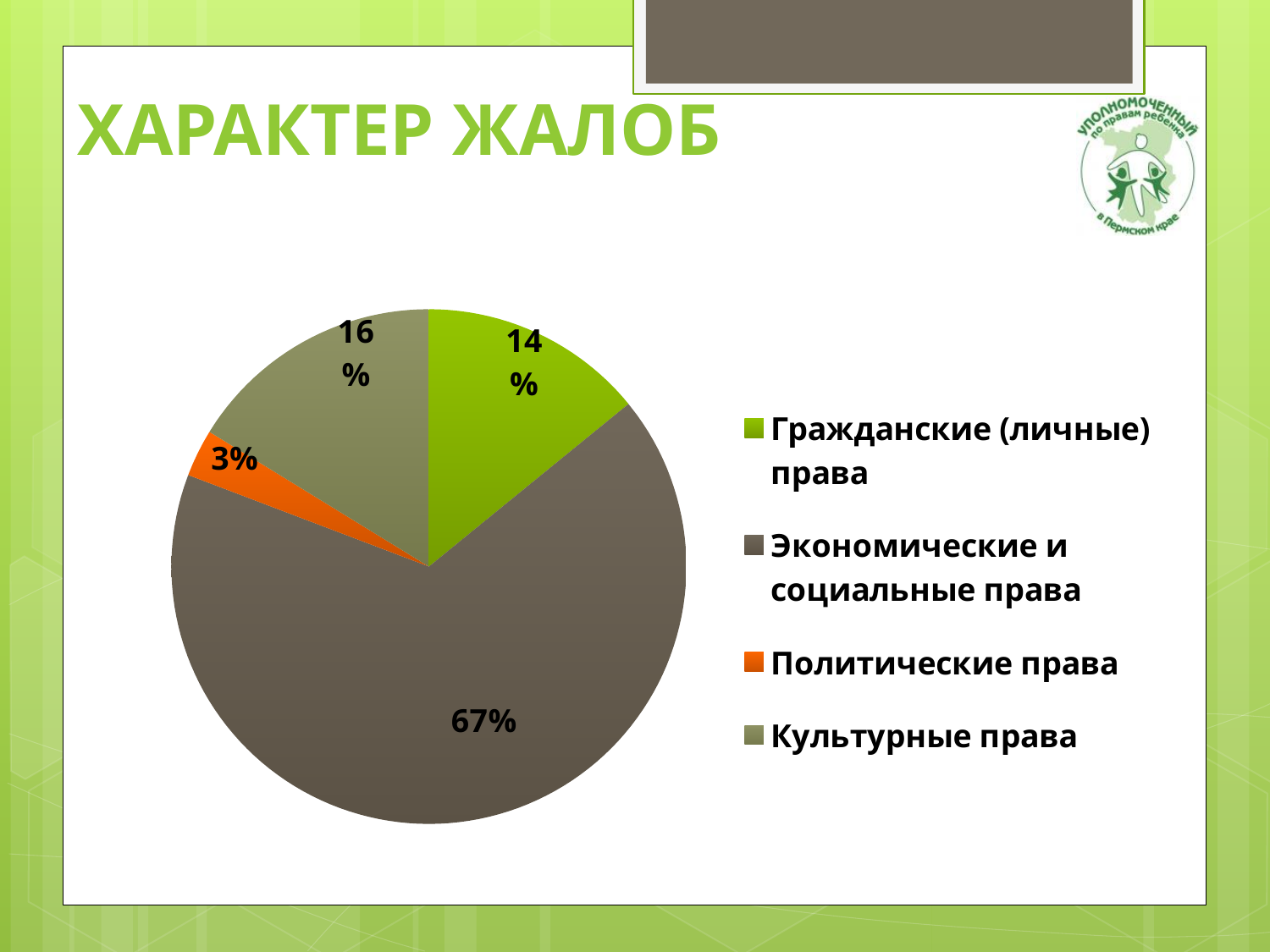
Which category has the smallest slice of the pie? Политические права Which is larger, the slice for Культурные права or the slice for Гражданские (личные) права? Культурные права What is the title of the slide containing the chart? ХАРАКТЕР ЖАЛОБ Which category has the largest slice of the pie? Экономические и социальные права What share of the pie does Экономические и социальные права take? 67% What share of the pie does Гражданские (личные) права take? 14% What share of the pie does Культурные права take? 16% How many categories are shown in the pie chart? 4 What kind of chart is shown on the slide? Pie chart What is the difference in percentage points between Экономические и социальные права and Культурные права? 51 What is the difference in percentage points between Культурные права and Гражданские (личные) права? 2